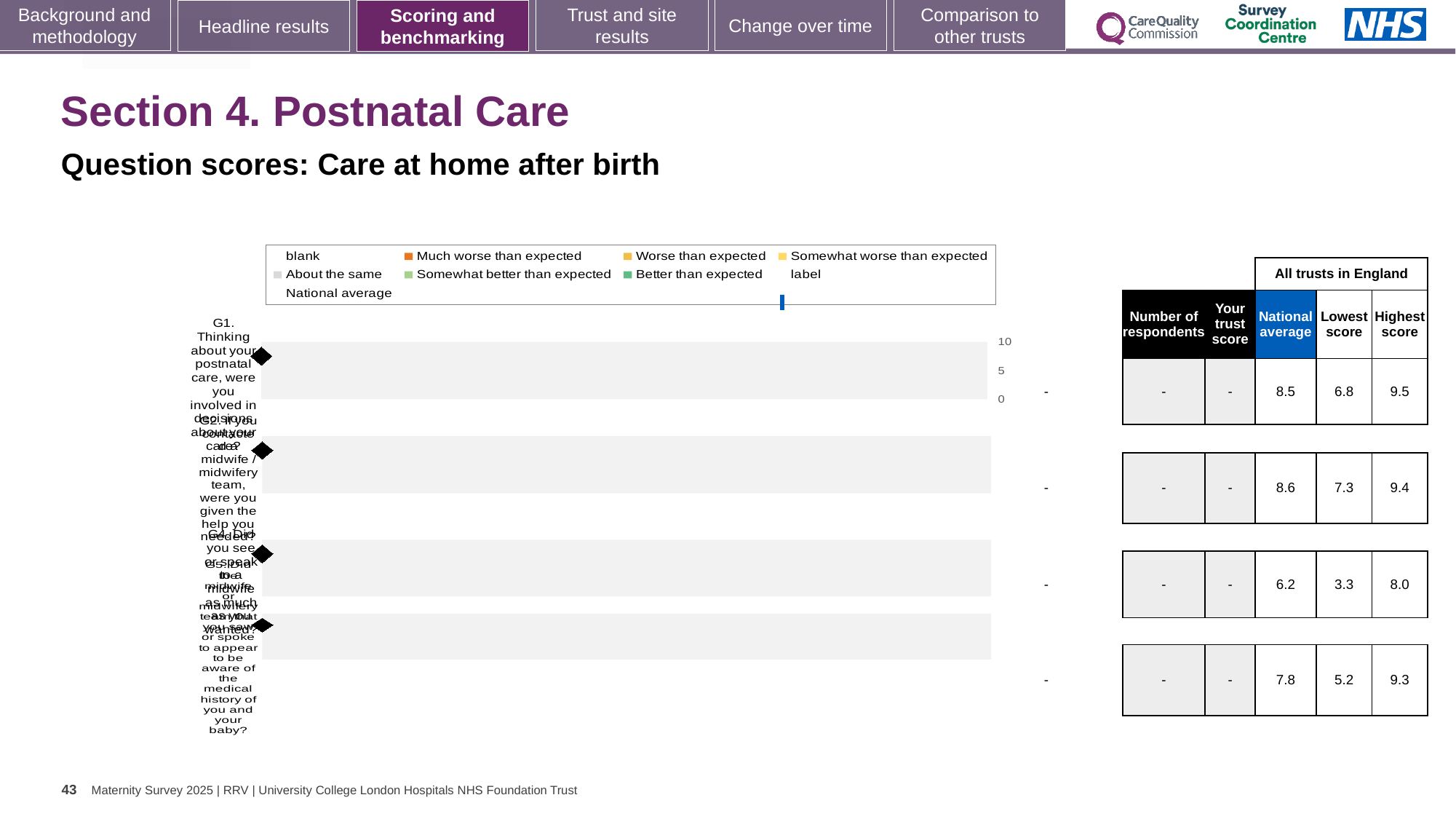
What is the highest value shown on the chart's numeric axis? 10 In the table next to the chart, what is the Highest score for question G1 (the first row)? 9.5 In the table next to the chart, what is the National average for question G1 (the first row)? 8.5 In the table next to the chart, what is the Highest score for the fourth row? 9.3 In the table next to the chart, what is the Lowest score for the third row? 3.3 In the table next to the chart, is the National average for question G2 (the second row) larger than that for the fourth row? Yes, 8.6 vs 7.8 In the table next to the chart, which row has the lowest National average? the third row (6.2) How many question rows (categories) does the chart show? 4 Which legend entry is shown with an orange marker? Much worse than expected In the table next to the chart, what is the National average for question G2 (the second row)? 8.6 In the table next to the chart, what is the difference between the Highest score and the Lowest score for question G1 (the first row)? 2.7 In the table next to the chart, what is the Lowest score for question G1 (the first row)? 6.8